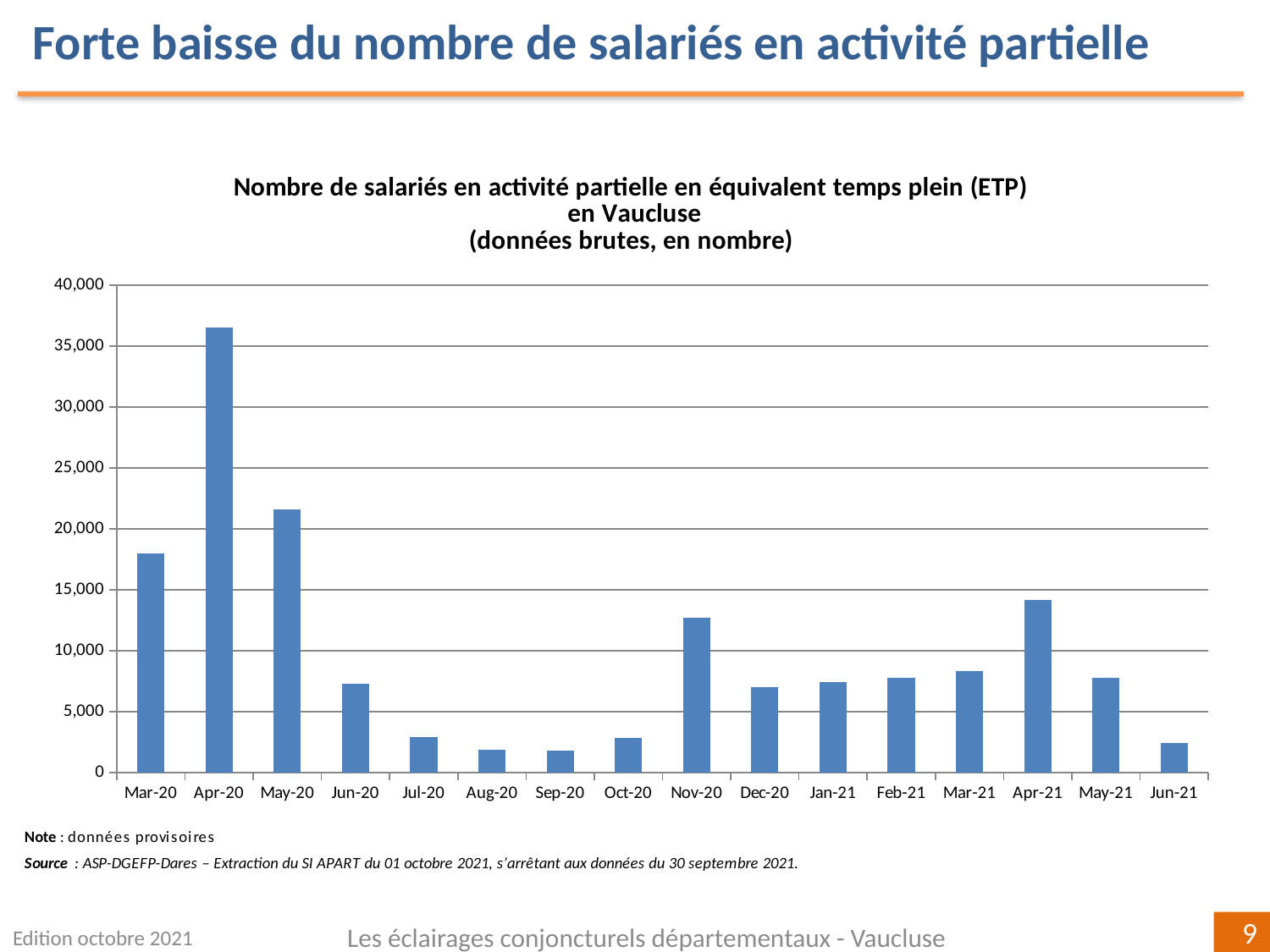
How many months are plotted on the x axis of the chart? 16 Which is larger, the value for Mar-20 or the value for May-20? May-20 Is the value for Apr-20 greater or less than 35,000? greater Do the values rise or fall from Apr-20 to Sep-20? fall Is the value for Mar-21 greater or less than 10,000? less Is the value for Nov-20 greater or less than 10,000? greater Which month has the highest number of salariés en activité partielle? Apr-20 Which département does the chart title say the data refer to? Vaucluse What kind of chart is shown on the slide? bar chart